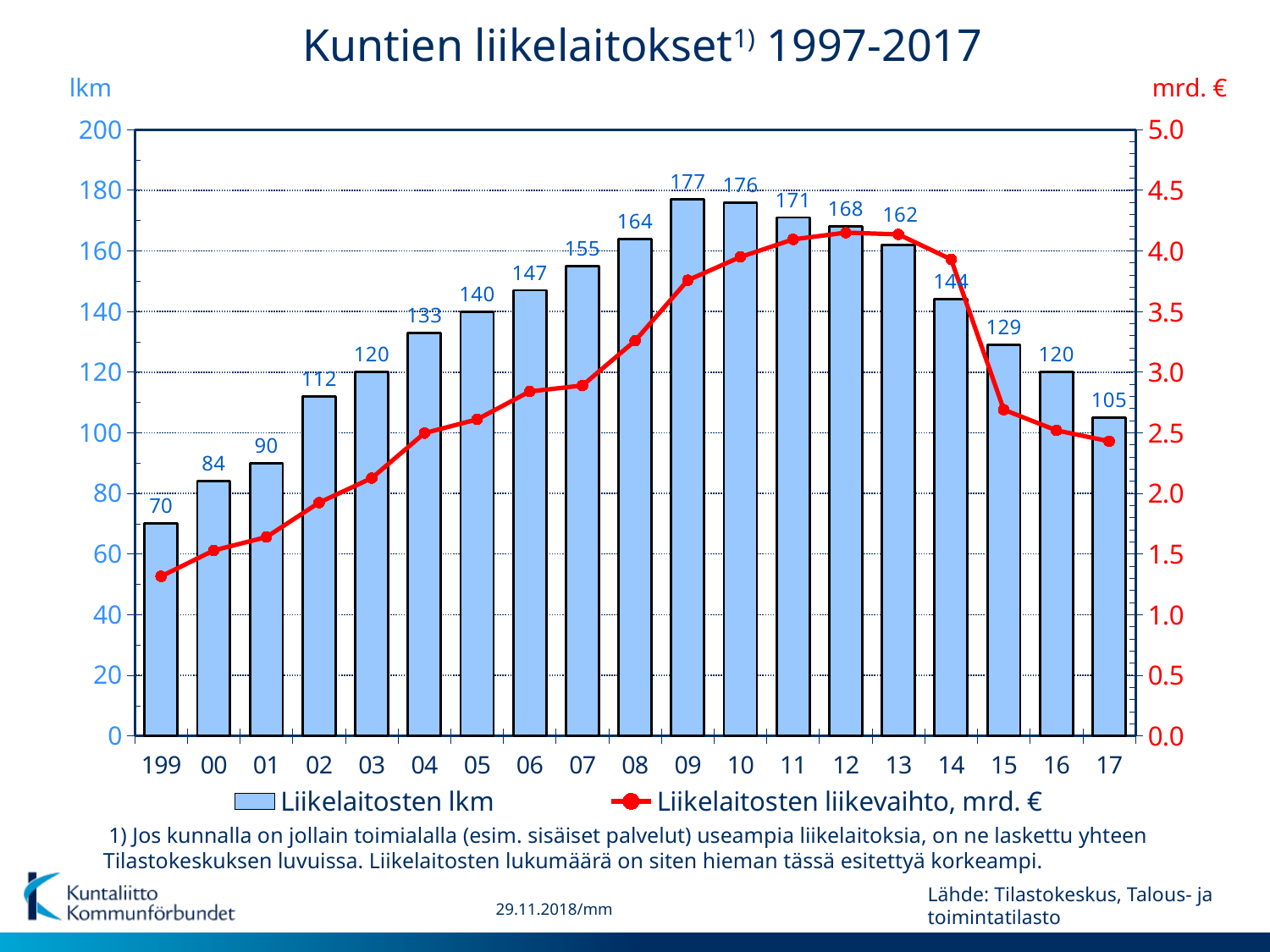
Is the value of the Liikelaitosten liikevaihto line for 2009 greater or less than 3.5 mrd. €? greater In which year is the Liikelaitosten lkm bar highest? 2009 How many years (bars) are shown in the chart? 19 What is the difference between the Liikelaitosten lkm values for 2010 and 2017? 71 What is the value of the Liikelaitosten lkm bar for 2002? 112 What is the number of liikelaitokset (Liikelaitosten lkm) shown for 2009? 177 In which year is the Liikelaitosten lkm bar lowest? 1997 How many series does the legend list? 2 What kind of chart is shown on the slide? Combined bar and line chart Which year has a higher Liikelaitosten lkm value, 2011 or 2013? 2011